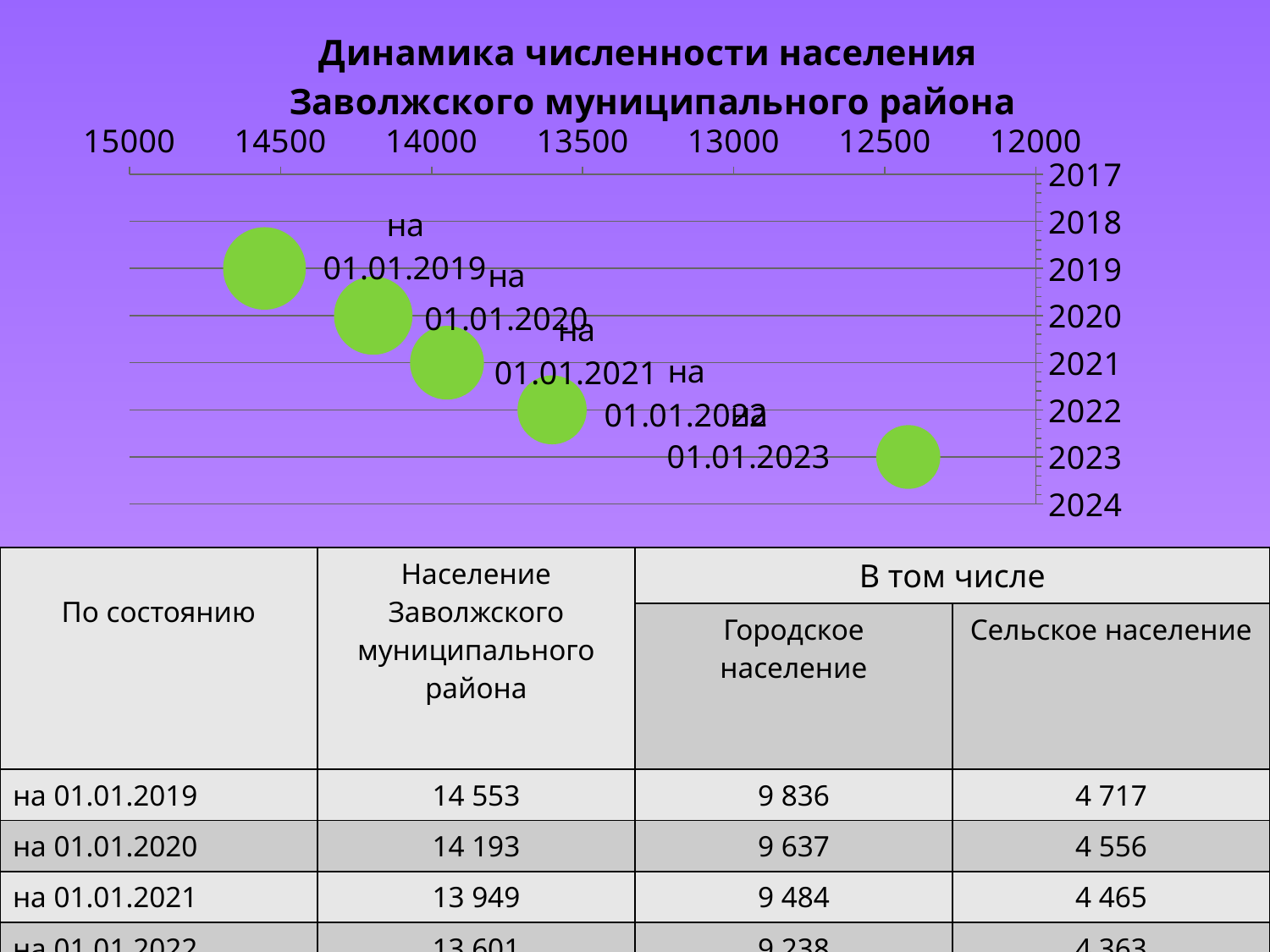
How many bubbles (data points) are plotted on the chart? 5 Which date has the highest population value on the chart? на 01.01.2019 Which is larger, the population value for на 01.01.2019 or for на 01.01.2023? на 01.01.2019 What kind of chart is shown on the slide? bubble chart Which date has the lowest population value on the chart? на 01.01.2023 What is the population of the Заволжский municipal district на 01.01.2019, as printed on the slide? 14 553 What is the title of the chart? Динамика численности населения Заволжского муниципального района Is the population value for на 01.01.2023 greater or less than 13000? less Do the population values rise or fall from 2019 to 2023? fall What is the population of the Заволжский municipal district на 01.01.2021, as printed on the slide? 13 949 What colour are the bubbles on the chart? green Is the population value for на 01.01.2019 greater or less than 14000? greater